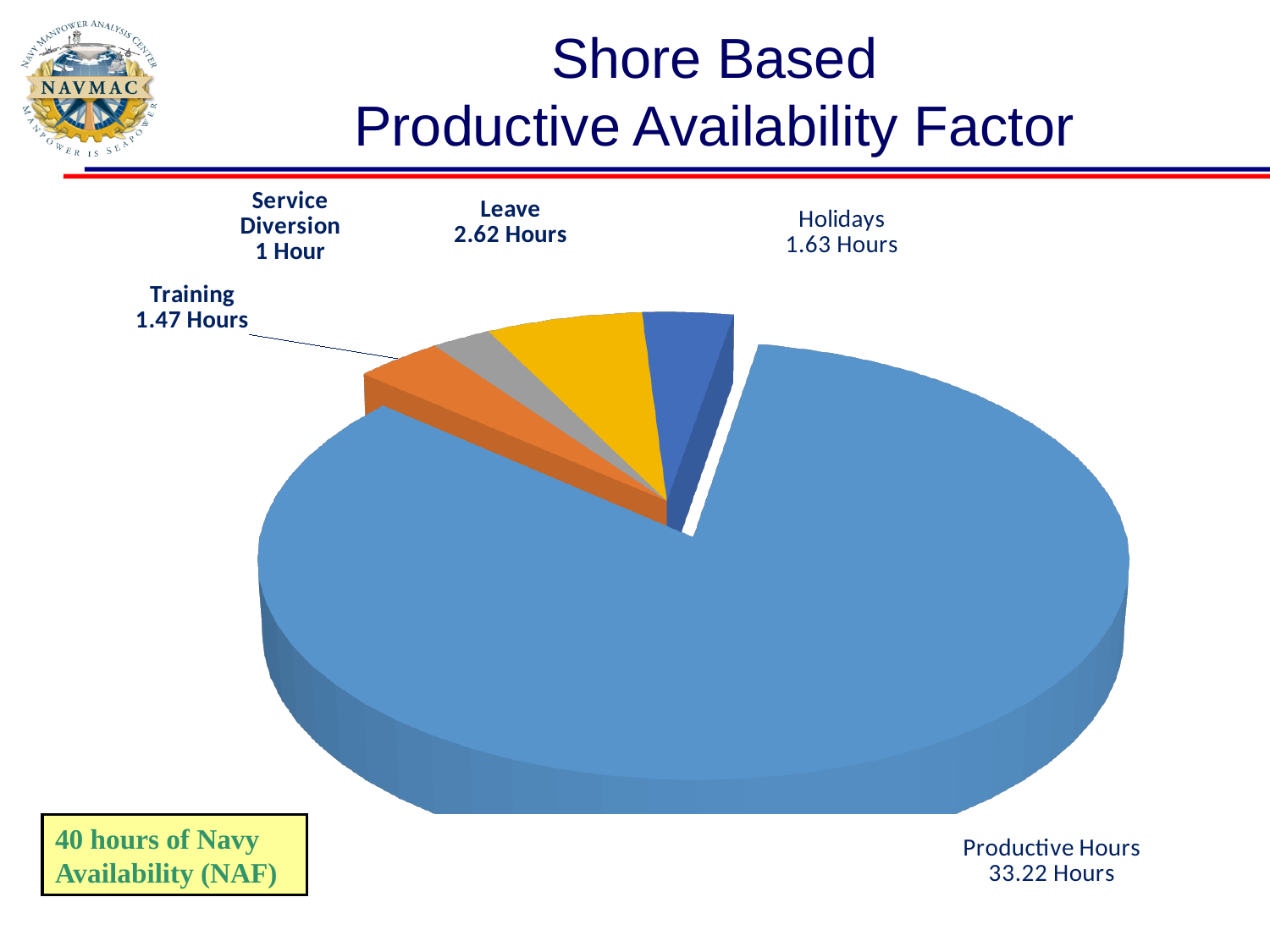
How many slices does the pie chart have? 5 How many hours are shown for Service Diversion? 1 Hour What kind of chart is shown on the slide? Pie chart What is the title of the slide containing the pie chart? Shore Based Productive Availability Factor What is the difference in hours between Leave and Holidays? 0.99 Hours Which slice of the pie is the largest? Productive Hours Which slice of the pie is the smallest? Service Diversion How many hours are shown for Productive Hours? 33.22 Hours Which is larger, Training or Holidays? Holidays How many hours are shown for Holidays? 1.63 Hours How many hours are shown for Leave? 2.62 Hours How many hours are shown for Training? 1.47 Hours